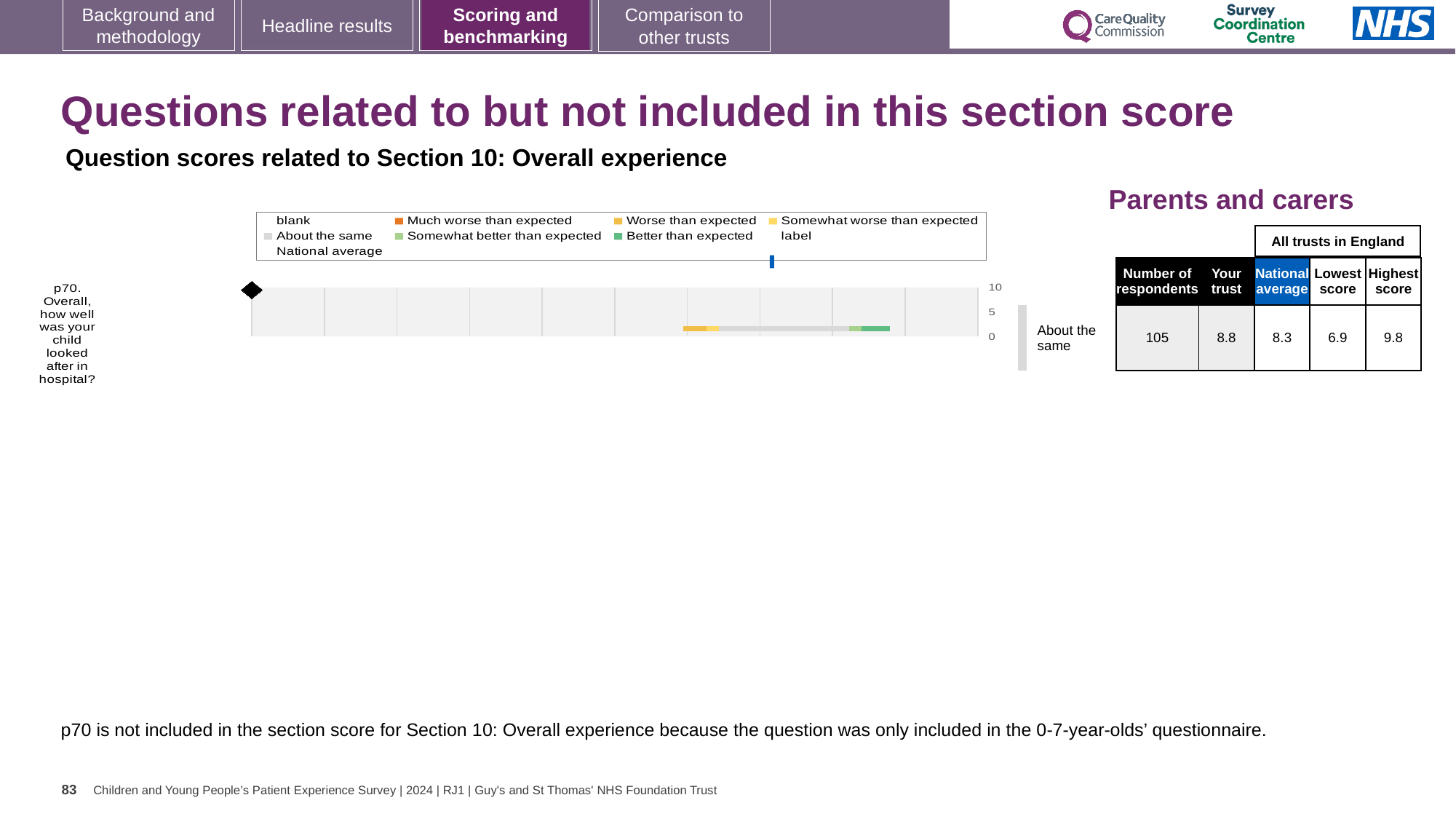
How many questions are plotted in the chart? 1 In the table beside the chart, what is the highest score among all trusts in England for p70? 9.8 What kind of chart is used to show the p70 question score? Bar chart For p70, what is the difference between the 'Your trust' score and the national average? 0.5 What label appears to the right of the bar for p70? About the same In the table beside the chart, how many respondents answered p70? 105 In the table beside the chart, what is the 'Your trust' score for p70? 8.8 In the table beside the chart, what is the lowest score among all trusts in England for p70? 6.9 For p70, what is the difference between the highest and lowest scores among all trusts in England? 2.9 In the table beside the chart, what is the national average score for p70? 8.3 Which question is plotted in the chart? p70. Overall, how well was your child looked after in hospital? For p70, which is larger: the 'Your trust' score or the national average? Your trust